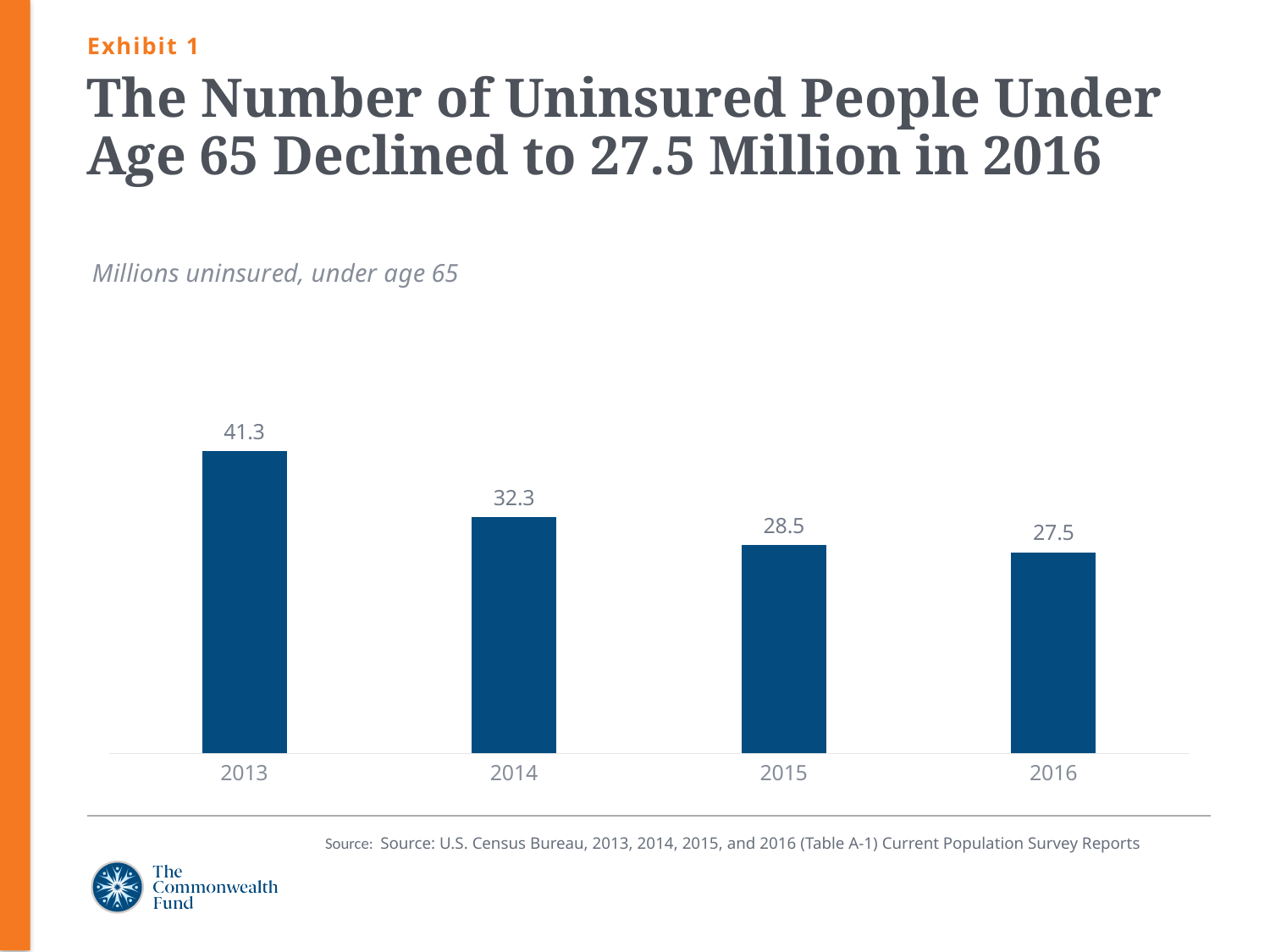
How many years are shown on the chart? 4 What kind of chart is shown on the slide? Bar chart What is the number of uninsured people under age 65 (in millions) shown for 2013? 41.3 What value is shown for 2016? 27.5 What value is shown for 2015? 28.5 What value is shown for 2014? 32.3 Which year has the lowest number of uninsured people under age 65? 2016 By how much did the number of uninsured (in millions) decline from 2013 to 2016? 13.8 Which year has a larger value, 2014 or 2015? 2014 What is the difference between the 2014 and 2015 values? 3.8 Which year has the highest number of uninsured people under age 65? 2013 Do the values rise or fall from 2013 to 2016? Fall